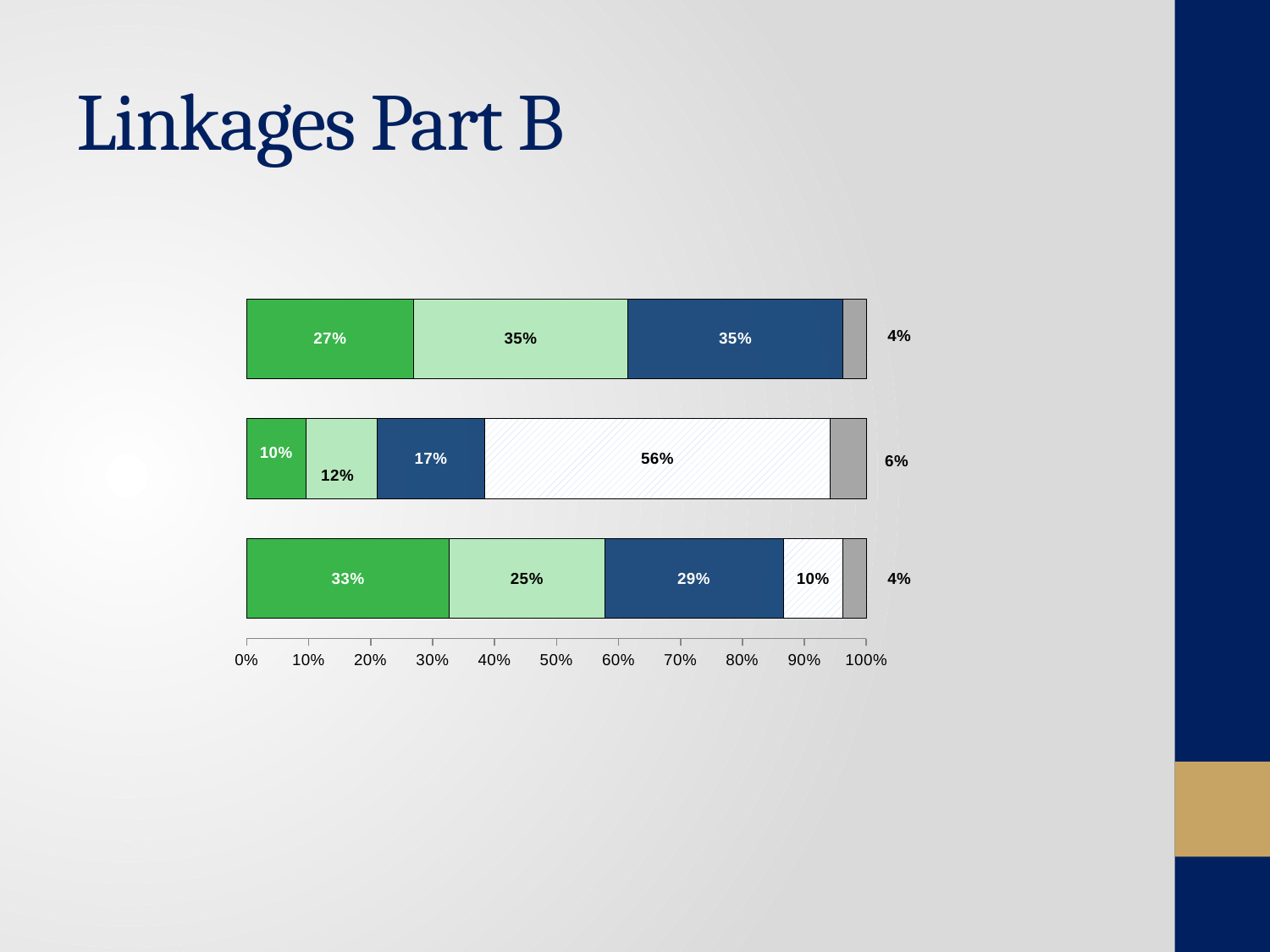
Which bar has the largest hatched white segment? The middle bar What is the value of the dark green segment in the top bar? 27% What is the title of the slide containing the chart? Linkages Part B Which is larger: the dark green segment of the top bar or the dark green segment of the bottom bar? The bottom bar What kind of chart is shown on the slide? Stacked bar chart What is the value of the dark blue segment in the bottom bar? 29% How many bars does the chart contain? 3 What is the difference between the hatched white segment of the middle bar and the hatched white segment of the bottom bar? 46% How many segments make up the middle bar? 5 What is the value of the hatched white segment in the middle bar? 56% What is the difference between the dark green segment of the bottom bar (33%) and the dark green segment of the top bar (27%)? 6% What is the value of the gray segment at the end of the middle bar? 6%